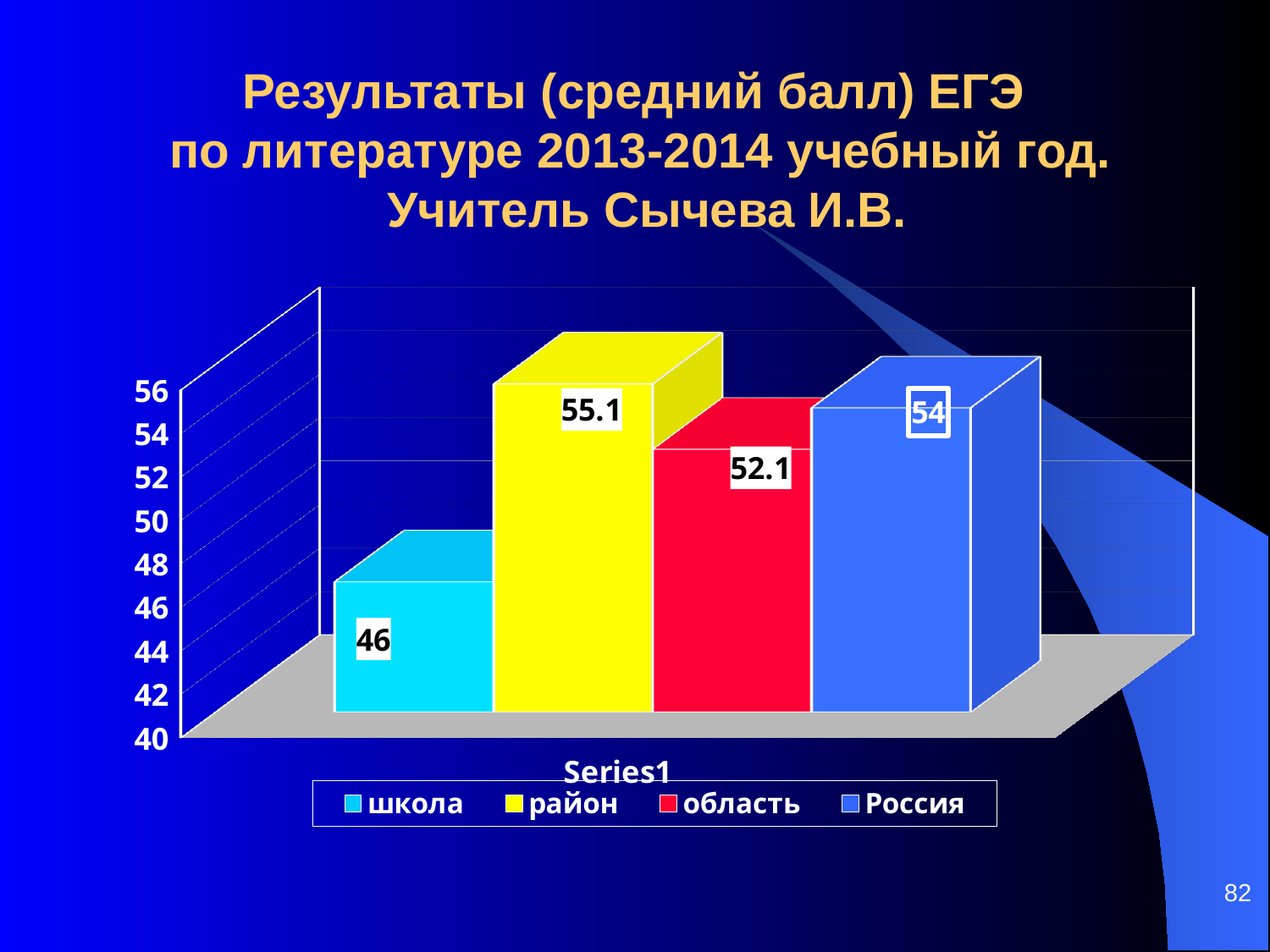
How many bars are plotted in the chart? 4 What is the value for Россия? 54 What is the difference between the values for район and школа? 9.1 What kind of chart is shown on the slide? bar chart What is the value for район? 55.1 Which category has the lowest value? школа How many entries does the legend list? 4 What is the difference between the values for Россия and область? 1.9 What is the value for школа? 46 Which category has the highest value? район What is the value for область? 52.1 Which is larger, the value for область or the value for Россия? Россия